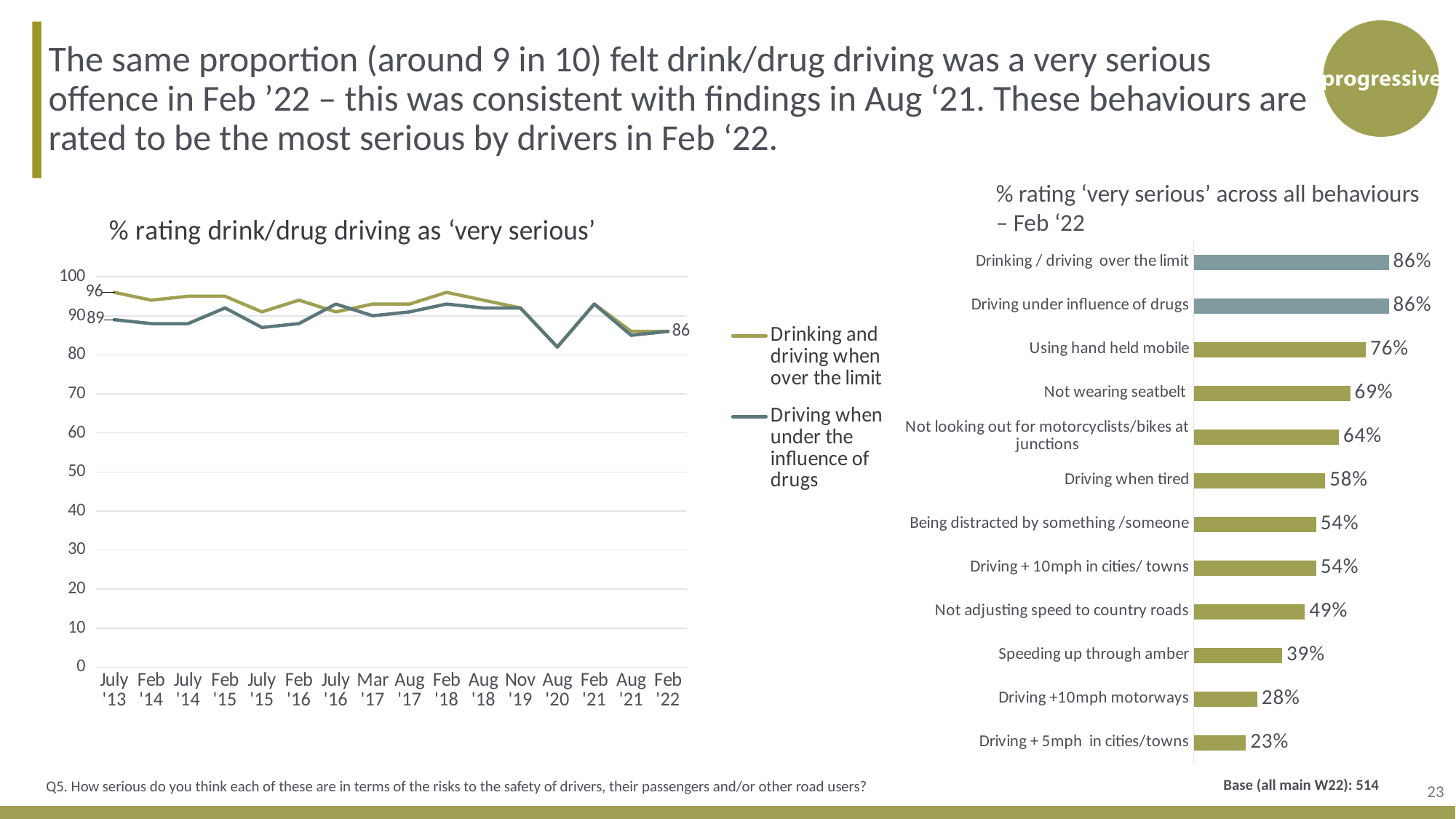
In the chart titled "% rating drink/drug driving as 'very serious'", is the value for Driving when under the influence of drugs in Aug '20 greater or less than 90? less In the chart titled "% rating 'very serious' across all behaviours – Feb '22", what is the value for Using hand held mobile? 76% In the chart titled "% rating drink/drug driving as 'very serious'", what is the value for Driving when under the influence of drugs in July '13? 89 In the chart titled "% rating 'very serious' across all behaviours – Feb '22", what is the value for Speeding up through amber? 39% What kind of chart is the one titled "% rating 'very serious' across all behaviours – Feb '22"? Bar chart In the chart titled "% rating 'very serious' across all behaviours – Feb '22", what is the difference between Not wearing seatbelt and Driving when tired? 11% In the chart titled "% rating 'very serious' across all behaviours – Feb '22", which behaviour has the lowest value? Driving + 5mph in cities/towns In the chart titled "% rating 'very serious' across all behaviours – Feb '22", which is larger: Not adjusting speed to country roads or Driving +10mph motorways? Not adjusting speed to country roads How many behaviours are listed in the chart titled "% rating 'very serious' across all behaviours – Feb '22"? 12 In the chart titled "% rating drink/drug driving as 'very serious'", what is the value for Drinking and driving when over the limit in July '13? 96 What kind of chart is the one titled "% rating drink/drug driving as 'very serious'"? Line chart How many series does the legend list in the chart titled "% rating drink/drug driving as 'very serious'"? 2